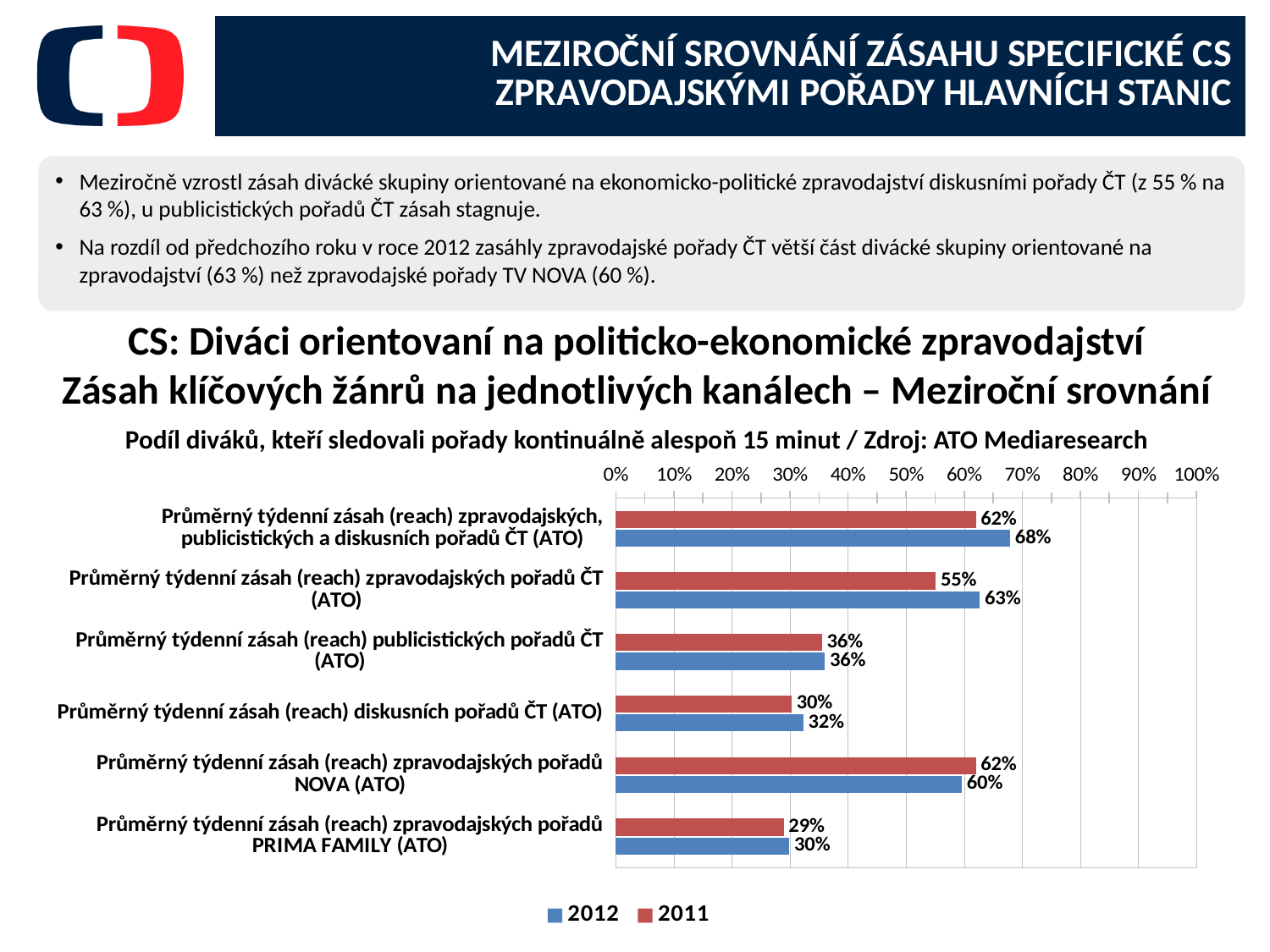
How many categories are shown on the chart? 6 Which series is shown in blue? 2012 What is the difference between the 2012 and 2011 values for Průměrný týdenní zásah (reach) zpravodajských pořadů ČT (ATO)? 8% Which category has the highest 2012 value? Průměrný týdenní zásah (reach) zpravodajských, publicistických a diskusních pořadů ČT (ATO) Is the 2012 value for Průměrný týdenní zásah (reach) diskusních pořadů ČT (ATO) greater or less than 40%? less For Průměrný týdenní zásah (reach) zpravodajských pořadů NOVA (ATO), which year has the larger value, 2012 or 2011? 2011 How many series does the legend list? 2 What is the 2012 value for Průměrný týdenní zásah (reach) zpravodajských pořadů ČT (ATO)? 63% Which category has the lowest 2011 value? Průměrný týdenní zásah (reach) zpravodajských pořadů PRIMA FAMILY (ATO) What kind of chart is shown on the slide? Bar chart What is the 2012 value for Průměrný týdenní zásah (reach) zpravodajských pořadů PRIMA FAMILY (ATO)? 30% What is the 2011 value for Průměrný týdenní zásah (reach) zpravodajských pořadů NOVA (ATO)? 62%